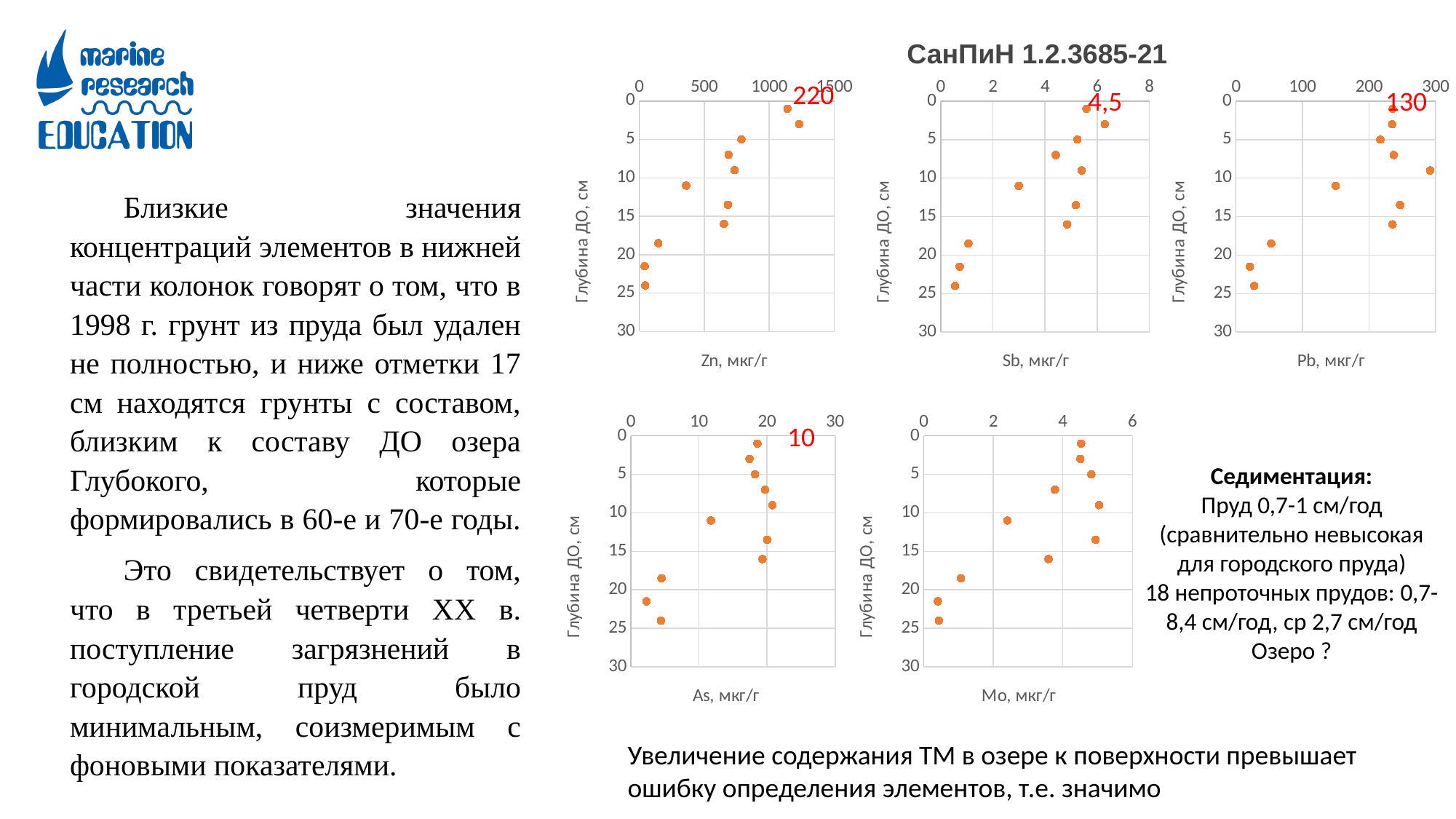
What red number is printed on the chart titled "Zn, мкг/г"? 220 In the chart titled "Mo, мкг/г", is the Mo value at a depth of 1 cm greater or less than 4? greater How many scatter charts are shown on the slide? 5 In the chart titled "Pb, мкг/г", do the Pb values generally increase or decrease as depth increases? decrease What is the vertical axis title of the chart titled "Mo, мкг/г"? Глубина ДО, см In the chart titled "Zn, мкг/г", is the Zn value at a depth of 3 cm greater or less than 1000? greater In the chart titled "As, мкг/г", is the As value at a depth of 24 cm greater or less than 10? less What kind of chart is the chart titled "Zn, мкг/г"? scatter chart In the chart titled "Zn, мкг/г", how many data points are plotted? 11